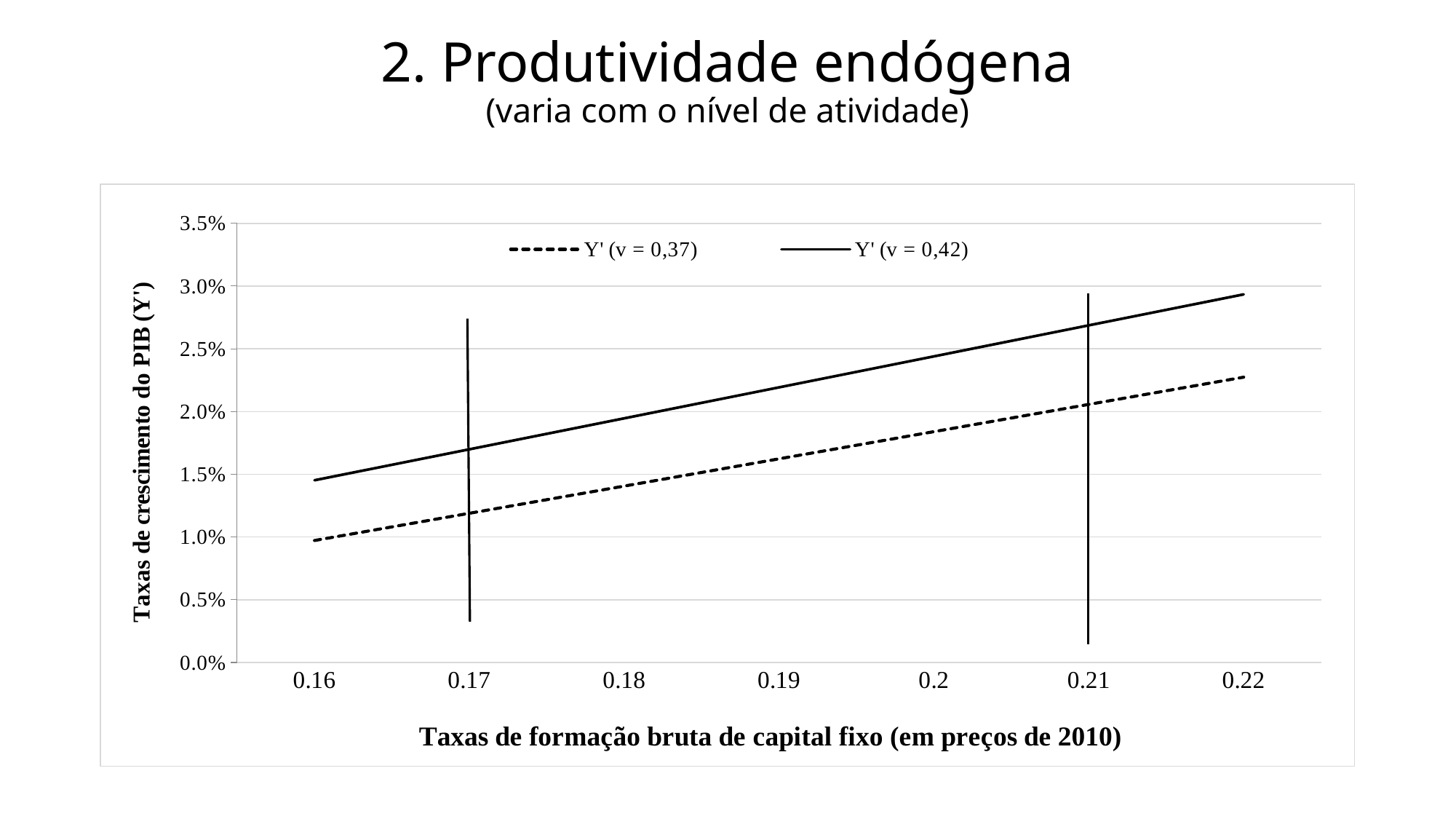
Is the value of Y' (v = 0,37) at x = 0.22 greater or less than 2.0%? greater Do the values of the Y' (v = 0,42) series rise or fall as the x axis increases from 0.16 to 0.22? rise How many series does the legend list? 2 Is the value of Y' (v = 0,42) at x = 0.22 greater or less than 2.5%? greater Is the value of Y' (v = 0,37) at x = 0.16 greater or less than 1.5%? less What is the title of the y axis of the chart? Taxas de crescimento do PIB (Y') At x = 0.22, which series has the higher value, Y' (v = 0,37) or Y' (v = 0,42)? Y' (v = 0,42) How many tick values are shown on the x axis? 7 What kind of chart is shown on the slide? line chart Which series is drawn with a dashed line? Y' (v = 0,37) Do the values of the Y' (v = 0,37) series rise or fall along the x axis? rise